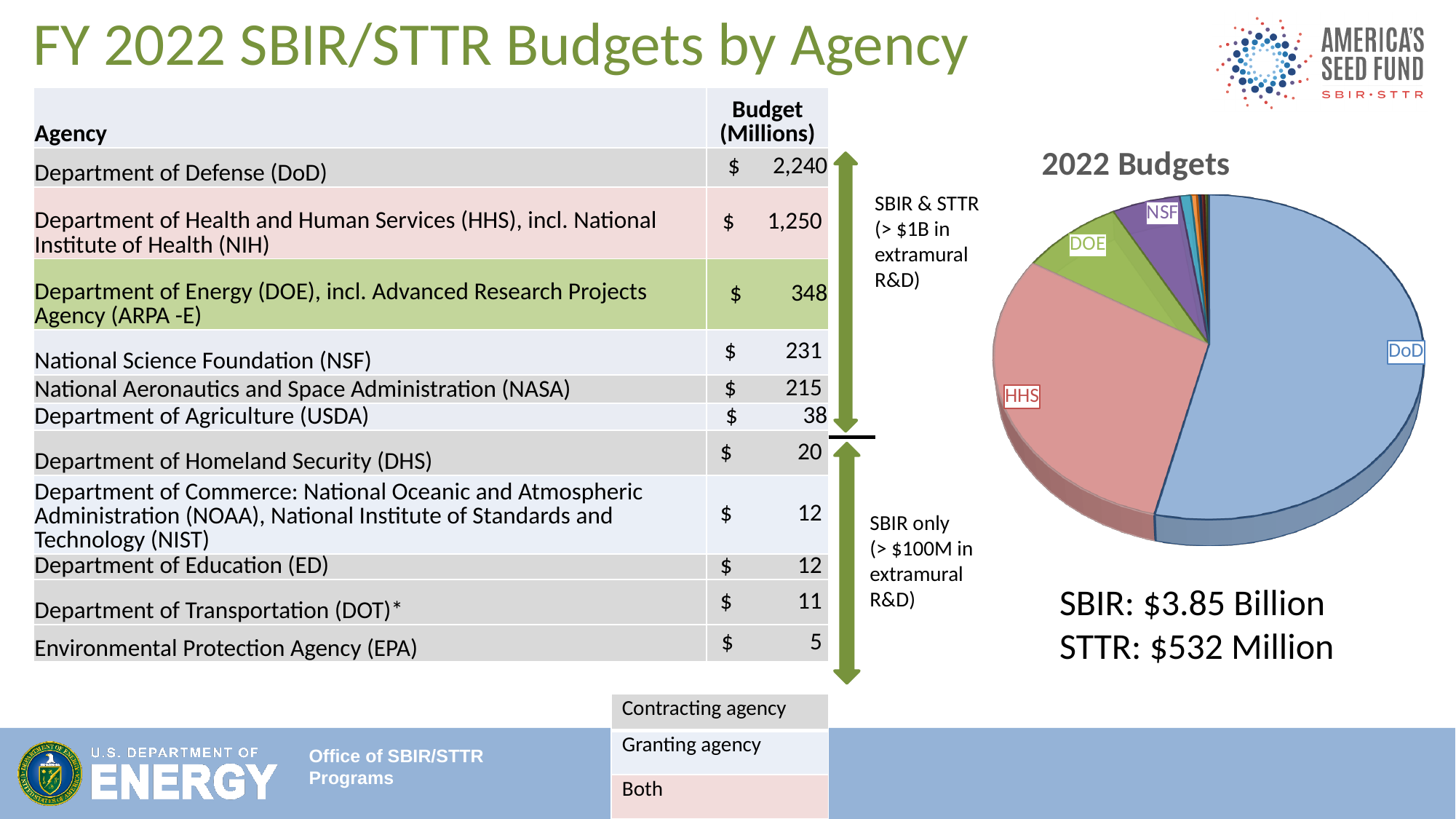
According to the table, what is the FY 2022 budget (in millions) for the HHS slice of the pie chart? $ 1,250 What kind of chart is the "2022 Budgets" chart on the right of the slide? pie chart In the "2022 Budgets" pie chart, which is larger, the DOE slice or the NSF slice? DOE Of the four labeled slices in the "2022 Budgets" pie chart (DoD, HHS, DOE, NSF), which is the smallest? NSF Using the table values, what is the difference in millions between the DoD and HHS budgets shown in the pie chart? 990 In the "2022 Budgets" pie chart, which is larger, the HHS slice or the DOE slice? HHS According to the table, what is the FY 2022 budget (in millions) for the DoD slice of the pie chart? $ 2,240 According to the table, what is the FY 2022 budget (in millions) for the DOE slice of the pie chart? $ 348 What colour is the DoD slice in the "2022 Budgets" pie chart? blue How many slices in the "2022 Budgets" pie chart have a visible agency label? 4 What is the title of the pie chart on the slide? 2022 Budgets In the "2022 Budgets" pie chart, which agency has the largest slice? DoD